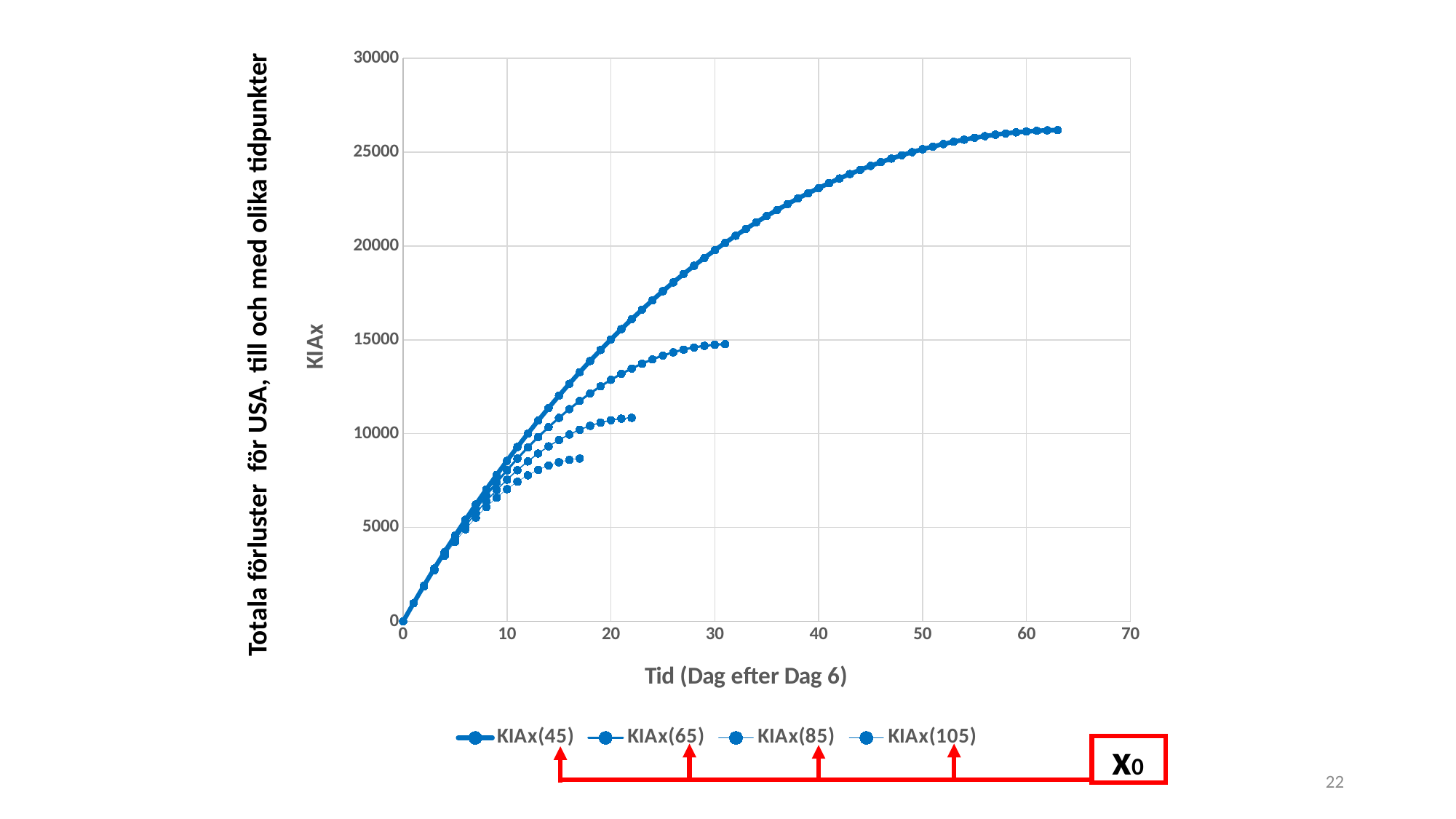
What is the maximum value shown on the y axis? 30000 Is the highest value reached by any series greater or less than 25000? greater What are the series names listed in the legend? KIAx(45), KIAx(65), KIAx(85), KIAx(105) Is the final value of the shortest series greater or less than 10000? less What value do all the series start at when x = 0? 0 Is the highest value reached by any series greater or less than 30000? less What kind of chart is shown on the slide? line chart What is the title of the x axis? Tid (Dag efter Dag 6) How many series does the legend list? 4 Do the values of the series rise or fall as the x axis increases? rise